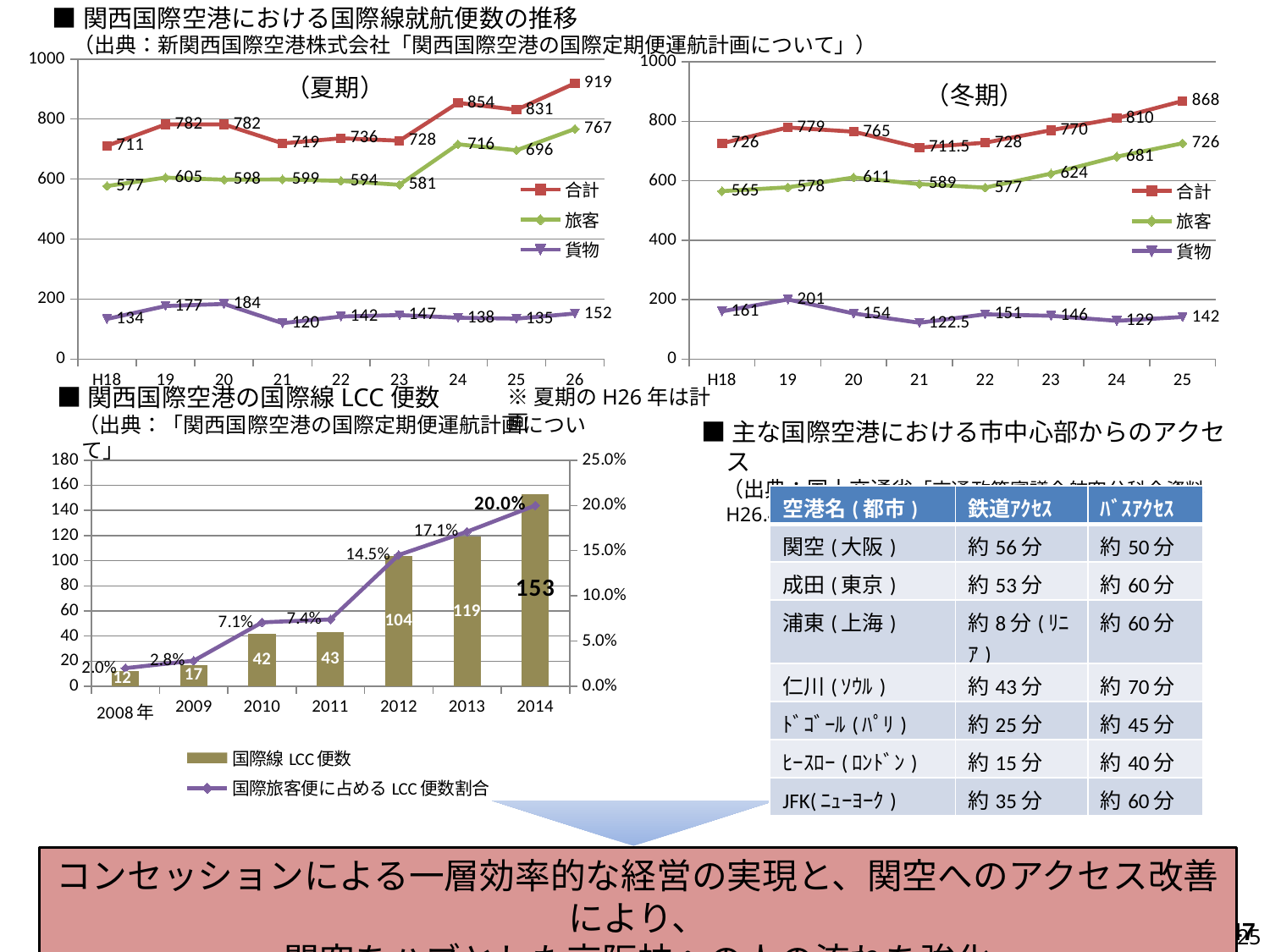
In the 関西国際空港の国際線LCC便数 chart, how many years are shown on the x axis? 7 In the 関西国際空港の国際線LCC便数 chart, what is the 国際旅客便に占めるLCC便数割合 for 2012? 14.5% In the summer (夏期) line chart, how many series does the legend list? 3 In the winter (冬期) line chart, in which year is the 旅客 value highest? 25 In the winter (冬期) line chart, what is the difference between 合計 and 旅客 in 25? 142 In the winter (冬期) line chart, which year has the larger 貨物 value, 19 or 20? 19 In the 関西国際空港の国際線LCC便数 chart, what is the 国際線LCC便数 value for 2014? 153 What kind of chart is the 関西国際空港の国際線LCC便数 chart? Combined bar and line chart In the summer (夏期) line chart, what is the 合計 value for H26? 919 In the summer (夏期) line chart, does the 合計 series rise or fall from 23 to 26? rises In the summer (夏期) line chart, in which year is the 貨物 value lowest? 21 In the winter (冬期) line chart, what is the 合計 value for 21? 711.5